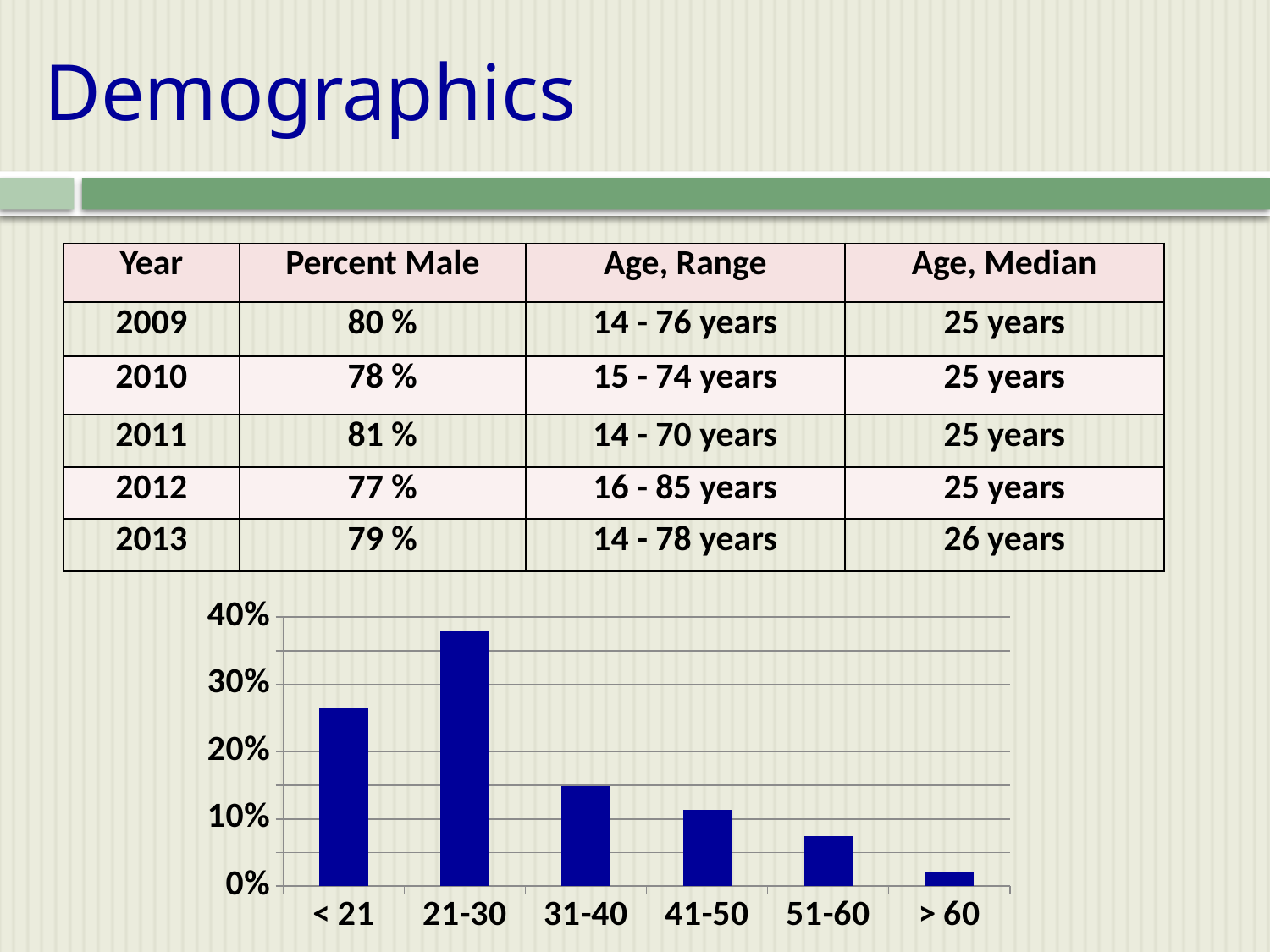
What is the highest tick label shown on the y axis of the bar chart? 40% Is the value for the 51-60 age group greater or less than 10%? less Is the value for the > 60 age group greater or less than 10%? less Which age category has the highest bar in the chart? 21-30 What kind of chart is shown at the bottom of the slide? bar chart Which has the larger value in the chart, the < 21 age group or the 31-40 age group? < 21 Is the value for the 31-40 age group greater or less than 20%? less How many age categories are shown on the x axis of the bar chart? 6 Which age category has the lowest bar in the chart? > 60 Do the bar values rise or fall moving from the 21-30 category to the > 60 category? fall